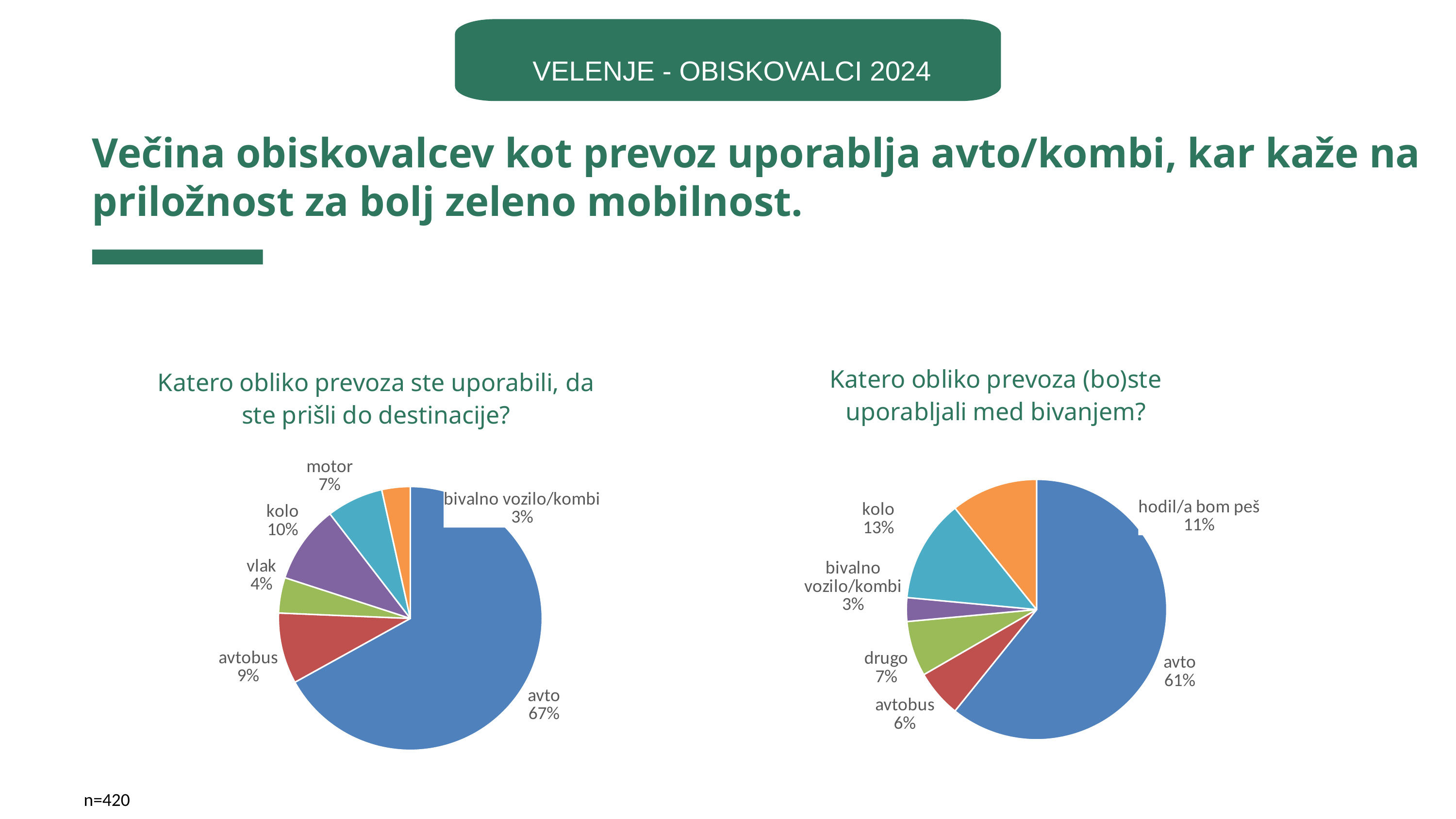
In the right chart ("Katero obliko prevoza (bo)ste uporabljali med bivanjem?"), which is larger, kolo or avtobus? kolo In the left chart ("Katero obliko prevoza ste uporabili, da ste prišli do destinacije?"), which category has the smallest slice? bivalno vozilo/kombi In the right chart ("Katero obliko prevoza (bo)ste uporabljali med bivanjem?"), what is the difference in percentage points between avto and kolo? 48 In the right chart ("Katero obliko prevoza (bo)ste uporabljali med bivanjem?"), what share is labelled for avto? 61% In the left chart ("Katero obliko prevoza ste uporabili, da ste prišli do destinacije?"), what share is labelled for avto? 67% In the right chart ("Katero obliko prevoza (bo)ste uporabljali med bivanjem?"), which category has the largest slice? avto In the left chart ("Katero obliko prevoza ste uporabili, da ste prišli do destinacije?"), which is larger, motor or kolo? kolo In the left chart ("Katero obliko prevoza ste uporabili, da ste prišli do destinacije?"), what share is labelled for kolo? 10% In the right chart ("Katero obliko prevoza (bo)ste uporabljali med bivanjem?"), what share is labelled for hodil/a bom peš? 11% In the left chart ("Katero obliko prevoza ste uporabili, da ste prišli do destinacije?"), what is the difference in percentage points between avtobus and vlak? 5 In the left chart ("Katero obliko prevoza ste uporabili, da ste prišli do destinacije?"), how many slices does the pie have? 6 What type of chart is used for both charts on the slide? pie chart